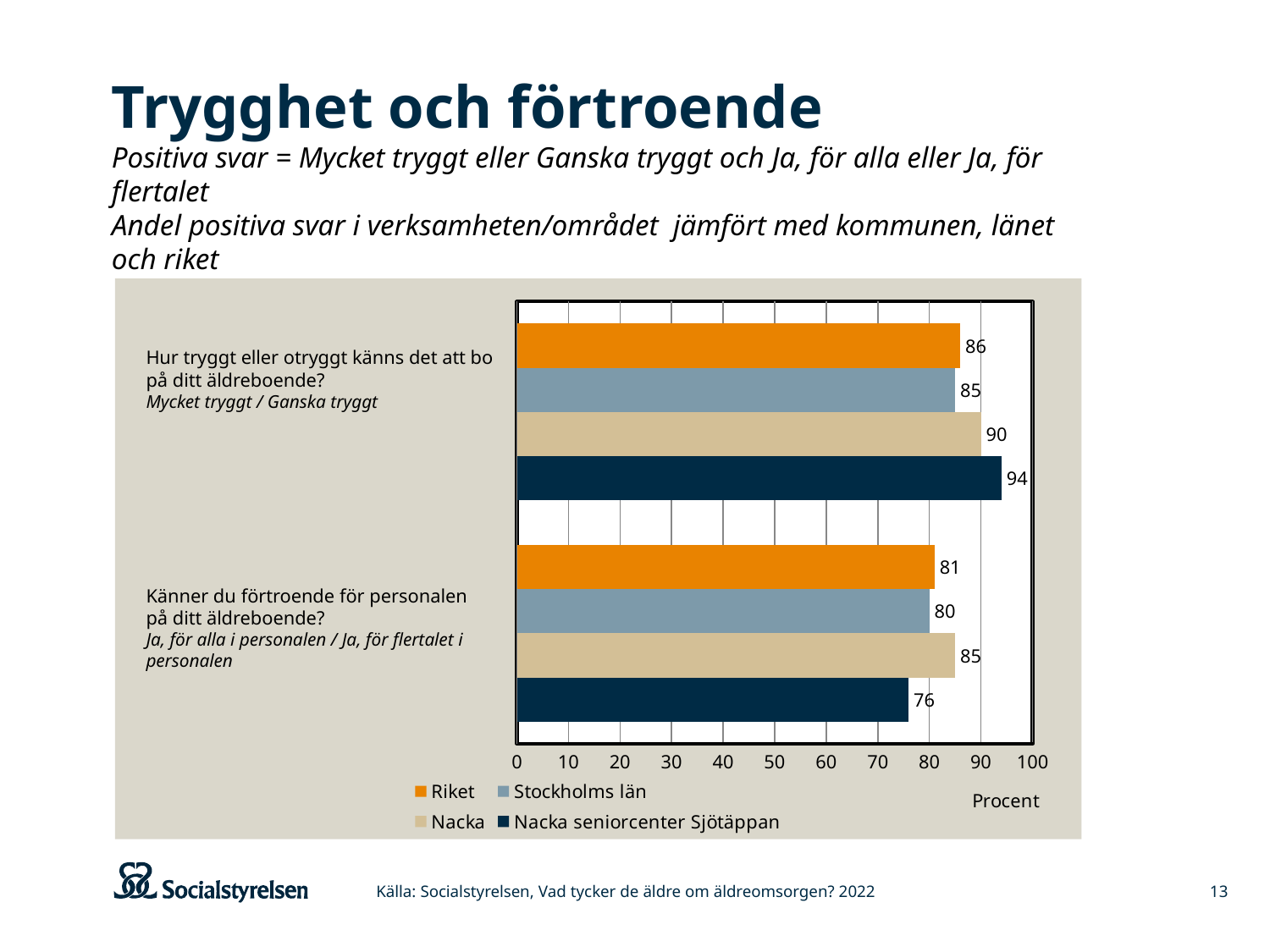
What is the value for Riket for the question "Känner du förtroende för personalen på ditt äldreboende?"? 81 What is the value for Nacka seniorcenter Sjötäppan for the question "Hur tryggt eller otryggt känns det att bo på ditt äldreboende?"? 94 What kind of chart is shown on the slide? Bar chart For the question "Känner du förtroende för personalen på ditt äldreboende?", which is larger: the value for Nacka or the value for Nacka seniorcenter Sjötäppan? Nacka How many question categories are shown on the chart? 2 Which series has the highest value for the question "Hur tryggt eller otryggt känns det att bo på ditt äldreboende?"? Nacka seniorcenter Sjötäppan What is the value for Nacka for the question "Känner du förtroende för personalen på ditt äldreboende?"? 85 What is the value for Stockholms län for the question "Hur tryggt eller otryggt känns det att bo på ditt äldreboende?"? 85 What is the difference between the Nacka seniorcenter Sjötäppan value and the Riket value for the question "Hur tryggt eller otryggt känns det att bo på ditt äldreboende?"? 8 How many series does the legend list? 4 Which series has the lowest value for the question "Känner du förtroende för personalen på ditt äldreboende?"? Nacka seniorcenter Sjötäppan What label is shown on the horizontal axis of the chart? Procent